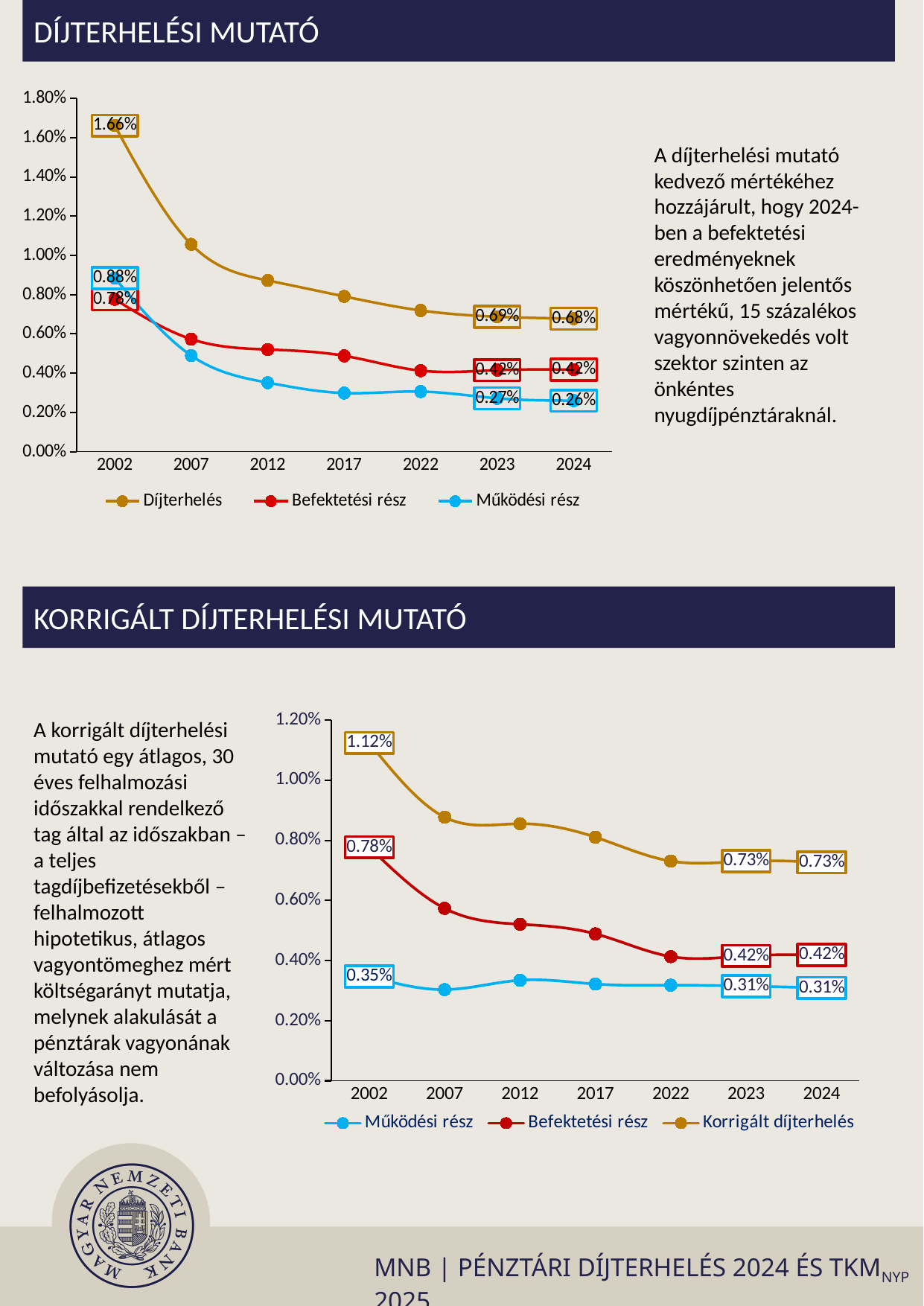
In the Díjterhelési mutató chart, does the Díjterhelés series rise or fall from 2002 to 2024? fall In the Díjterhelési mutató chart, what is the Befektetési rész value for 2023? 0.42% In the Korrigált díjterhelési mutató chart, what is the Korrigált díjterhelés value for 2002? 1.12% In the Díjterhelési mutató chart, what is the Díjterhelés value for 2002? 1.66% In the Korrigált díjterhelési mutató chart, which series has the highest value in 2024? Korrigált díjterhelés In the Díjterhelési mutató chart, how many series does the legend list? 3 In the Korrigált díjterhelési mutató chart, what is the Működési rész value for 2023? 0.31% In the Díjterhelési mutató chart, what is the Működési rész value for 2024? 0.26% What kind of chart is the Korrigált díjterhelési mutató chart? line chart In the Díjterhelési mutató chart, by how much did the Díjterhelés value fall from 2002 to 2024? 0.98% In the Díjterhelési mutató chart, is the Díjterhelés value for 2007 greater or less than 1.00%? greater In the Korrigált díjterhelési mutató chart, what is the difference between the Befektetési rész and Működési rész values in 2024? 0.11%